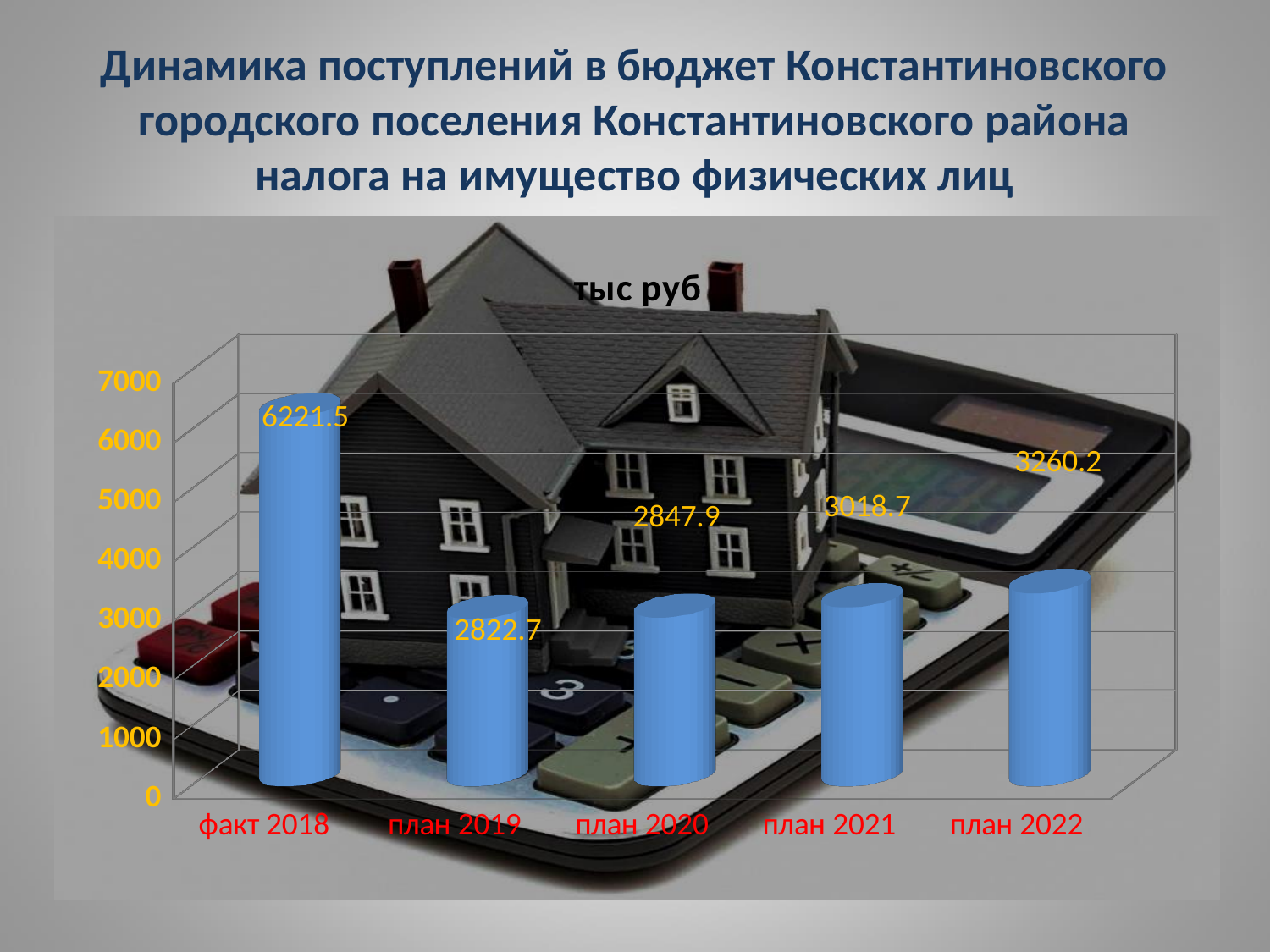
What is the difference between the values for факт 2018 and план 2019? 3398.8 What is the value for план 2022? 3260.2 How many categories are shown on the x axis? 5 What is the difference between the values for план 2022 and план 2021? 241.5 What is the value for план 2021? 3018.7 Which category has the highest value? факт 2018 Do the values rise or fall from план 2019 to план 2022? rise Which category has the lowest value? план 2019 What is the value for факт 2018? 6221.5 What kind of chart is shown on the slide? bar chart Is the value for план 2020 greater or less than 3000? less Which is larger, the value for план 2020 or the value for план 2022? план 2022